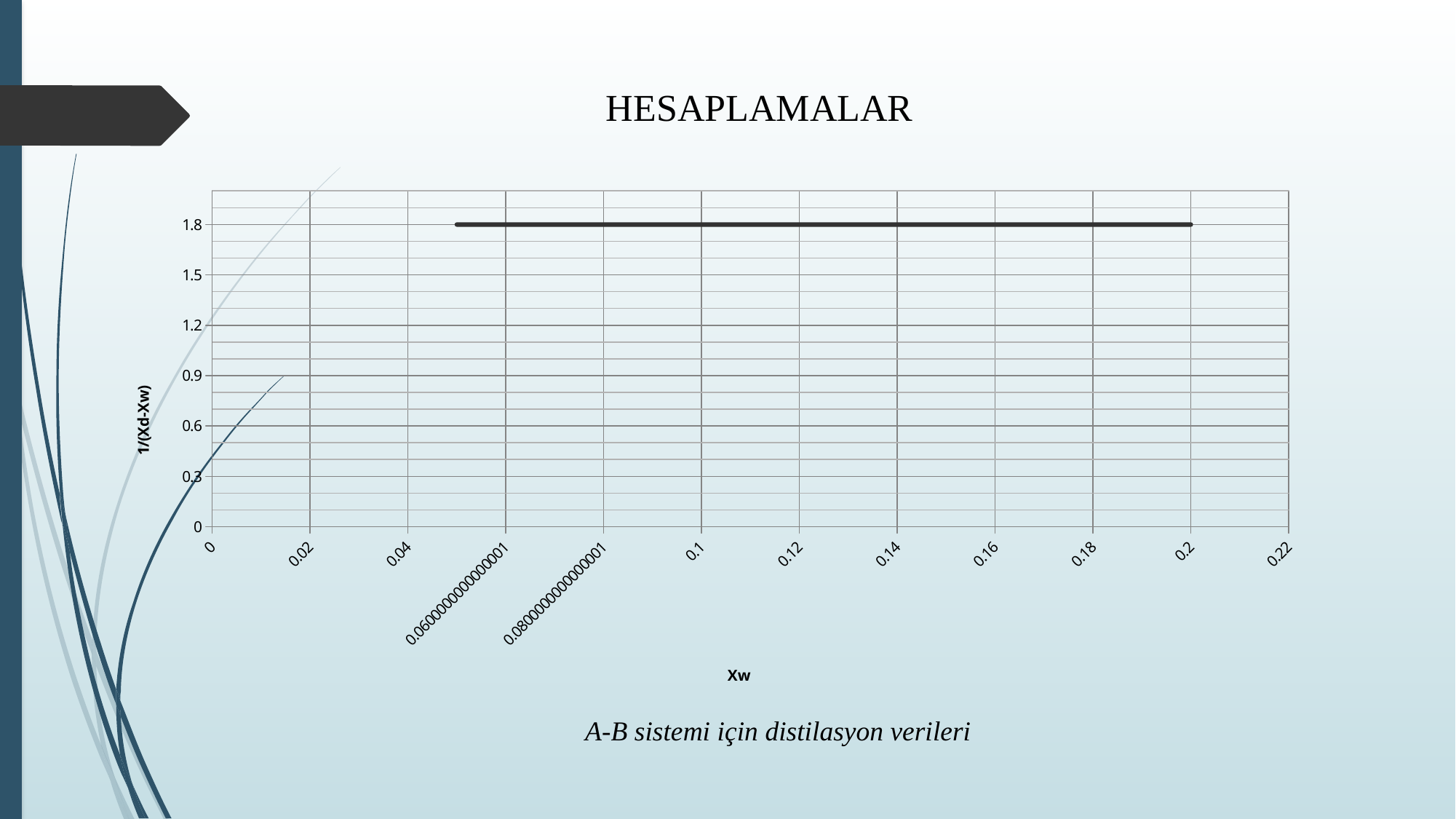
What value of 1/(Xd-Xw) does the plotted line sit on across its whole length? 1.8 What is the label of the horizontal axis of the chart? Xw What kind of chart is shown on the slide? line chart What is the highest tick value shown on the vertical axis? 1.8 Is the value of 1/(Xd-Xw) at Xw = 0.1 greater or less than 1.5? greater Does the plotted line rise, fall, or stay flat as Xw increases? stays flat Is the value of 1/(Xd-Xw) at Xw = 0.16 greater or less than 0.9? greater Is the value of 1/(Xd-Xw) at Xw = 0.2 greater or less than 1.2? greater What is the label of the vertical axis of the chart? 1/(Xd-Xw) Is the value of 1/(Xd-Xw) at Xw = 0.12 larger than, smaller than, or equal to the value at Xw = 0.18? equal